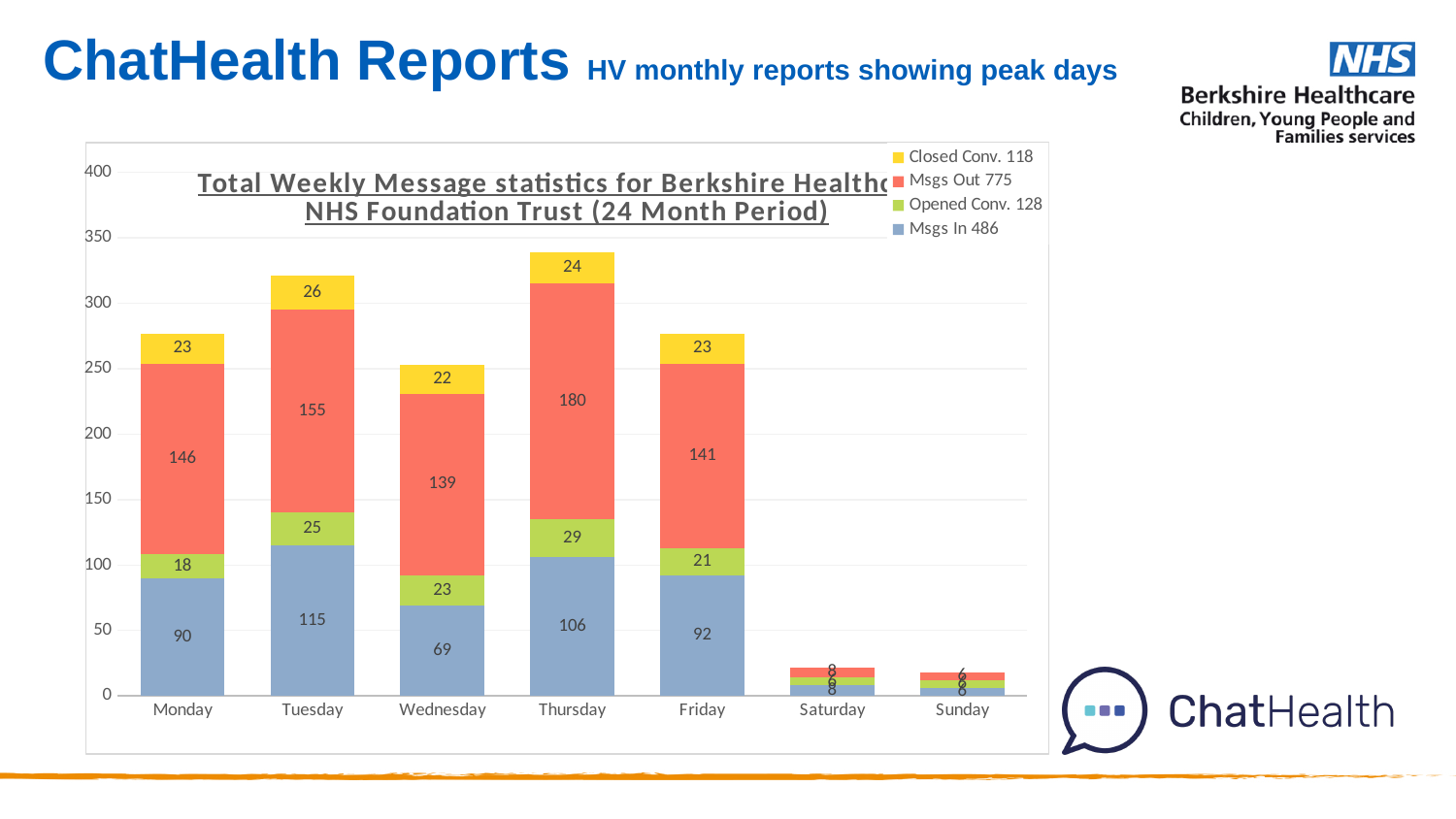
How many days are shown on the x axis? 7 Is the Msgs In value for Monday larger than the Msgs In value for Friday? No Which day has the tallest stacked bar overall? Thursday Which day has the highest Msgs In value? Tuesday How many series does the legend list? 4 Is the total stacked bar for Wednesday greater or less than 300? less What is the Msgs In value for Tuesday? 115 What is the total of the stacked bar for Tuesday? 321 What is the Opened Conv. value for Wednesday? 23 What type of chart is shown on the slide? stacked bar chart What is the Msgs Out value for Thursday? 180 What is the difference between the Msgs Out values for Thursday and Wednesday? 41